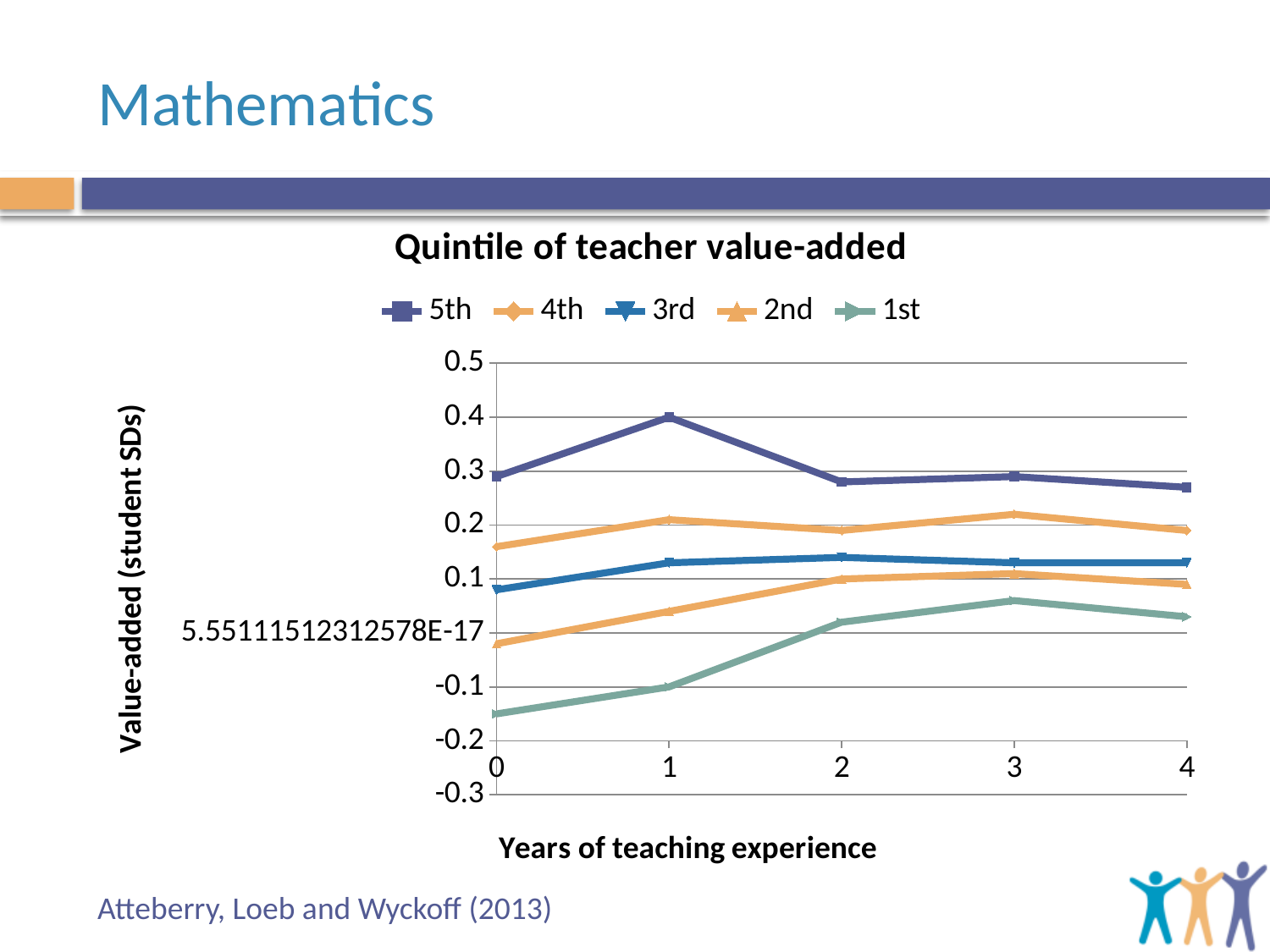
How many series does the legend list? 5 Which is larger at 3 years of experience: the value for the 4th quintile or the 2nd quintile? 4th Which quintile has the highest value-added at 1 year of teaching experience? 5th Which quintile has the lowest value-added at 0 years of teaching experience? 1st Is the value for the 5th quintile at 1 year of experience greater or less than 0.3? greater Is the value for the 1st quintile at 0 years of experience greater or less than -0.1? less What is the title of the chart? Quintile of teacher value-added What kind of chart is shown on the slide? line chart How many years of teaching experience are plotted along the x axis? 5 Does the value-added for the 1st quintile generally rise or fall from 0 to 3 years of teaching experience? rise What is the label of the x axis? Years of teaching experience Is the value for the 3rd quintile at 2 years of experience greater or less than 0.1? greater